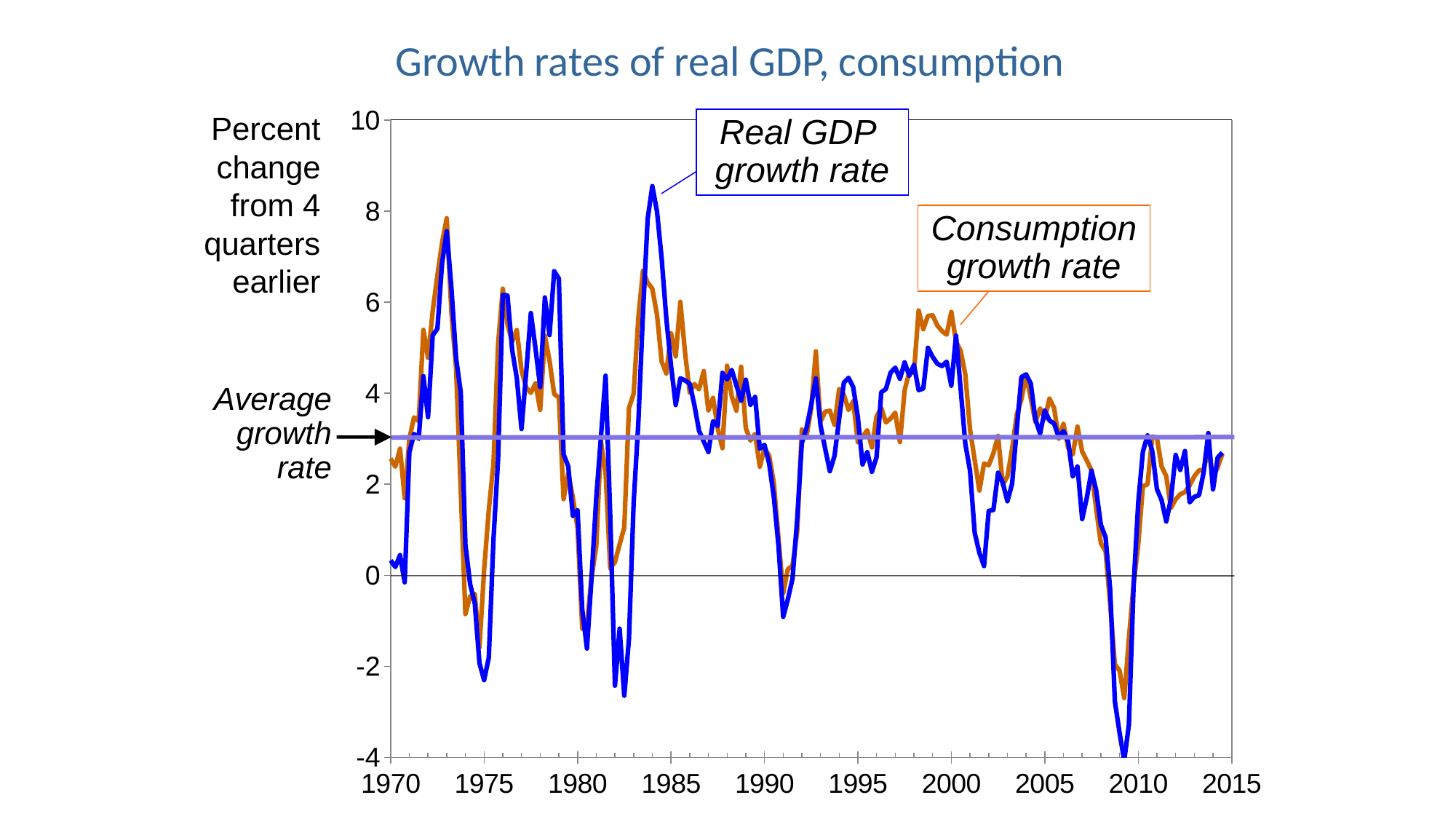
What does the horizontal purple line on the chart represent? Average growth rate What is the title of the chart? Growth rates of real GDP, consumption Is the real GDP growth rate at its lowest point around 2009 greater or less than -2? less What is the lowest value shown on the vertical axis? -4 Is the average growth rate line greater or less than 2? greater Around 1984, which series reaches a higher peak: the real GDP growth rate or the consumption growth rate? Real GDP growth rate What kind of chart is shown on the slide? Line chart What is the last year shown on the horizontal axis? 2015 Around 2009, which series falls lower: the real GDP growth rate or the consumption growth rate? Real GDP growth rate Is the real GDP growth rate at its peak around 1984 greater or less than 8? greater What is the highest value shown on the vertical axis? 10 What is the first year shown on the horizontal axis? 1970